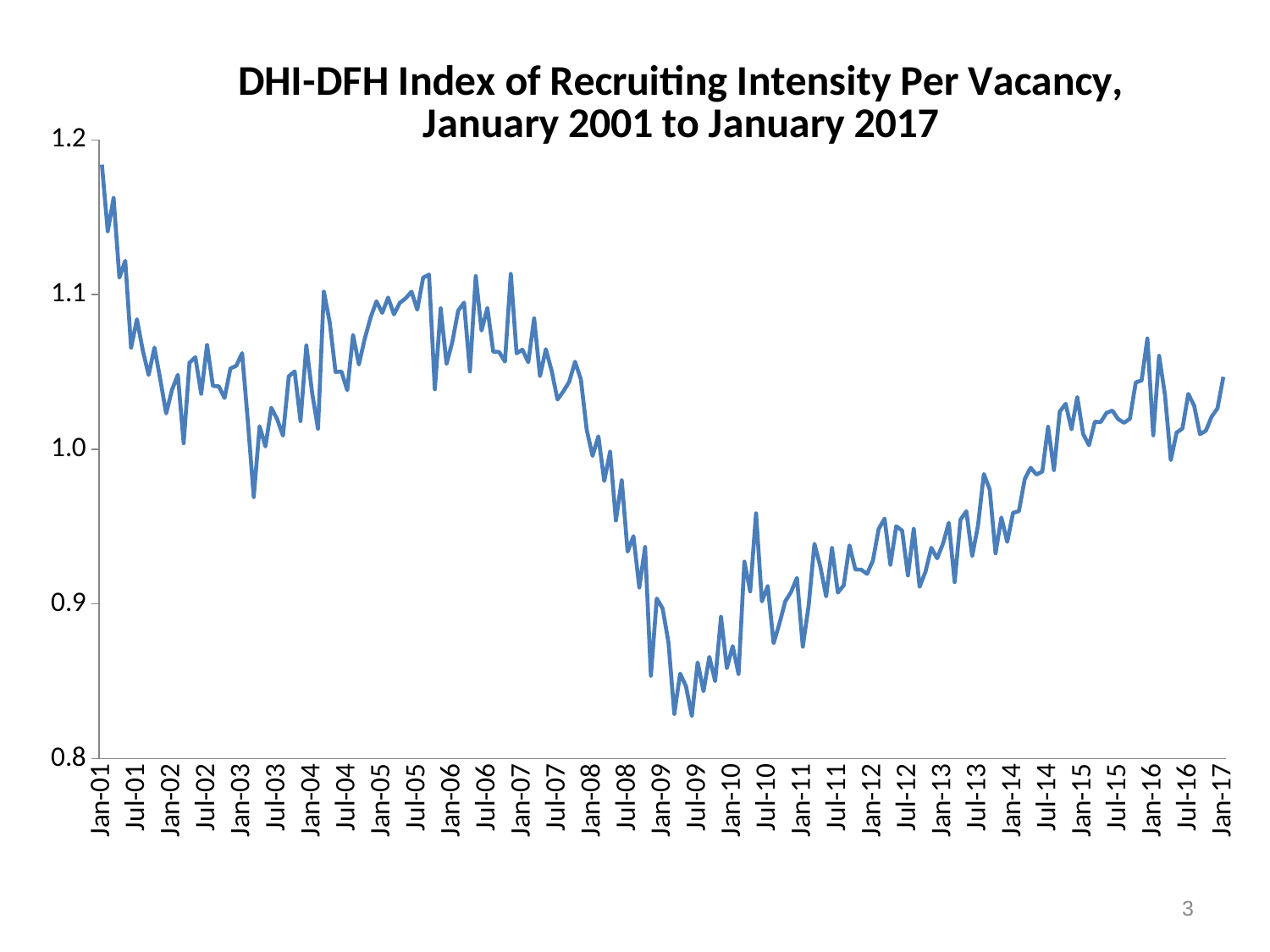
Which is larger, the value at Jan-01 or the value at Jan-17? Jan-01 What kind of chart is shown on the slide? line chart What is the highest value shown on the y axis? 1.2 Is the value for Jul-05 greater or less than 1.0? greater Is the value for Jan-14 greater or less than 1.0? less Does the index rise or fall between Jan-08 and Jul-09? fall Is the value for Jan-17 greater or less than 1.0? greater At which x-axis label is the index at its highest? Jan-01 Around which x-axis label does the index reach its lowest point? Jul-09 What is the title of the chart? DHI-DFH Index of Recruiting Intensity Per Vacancy, January 2001 to January 2017